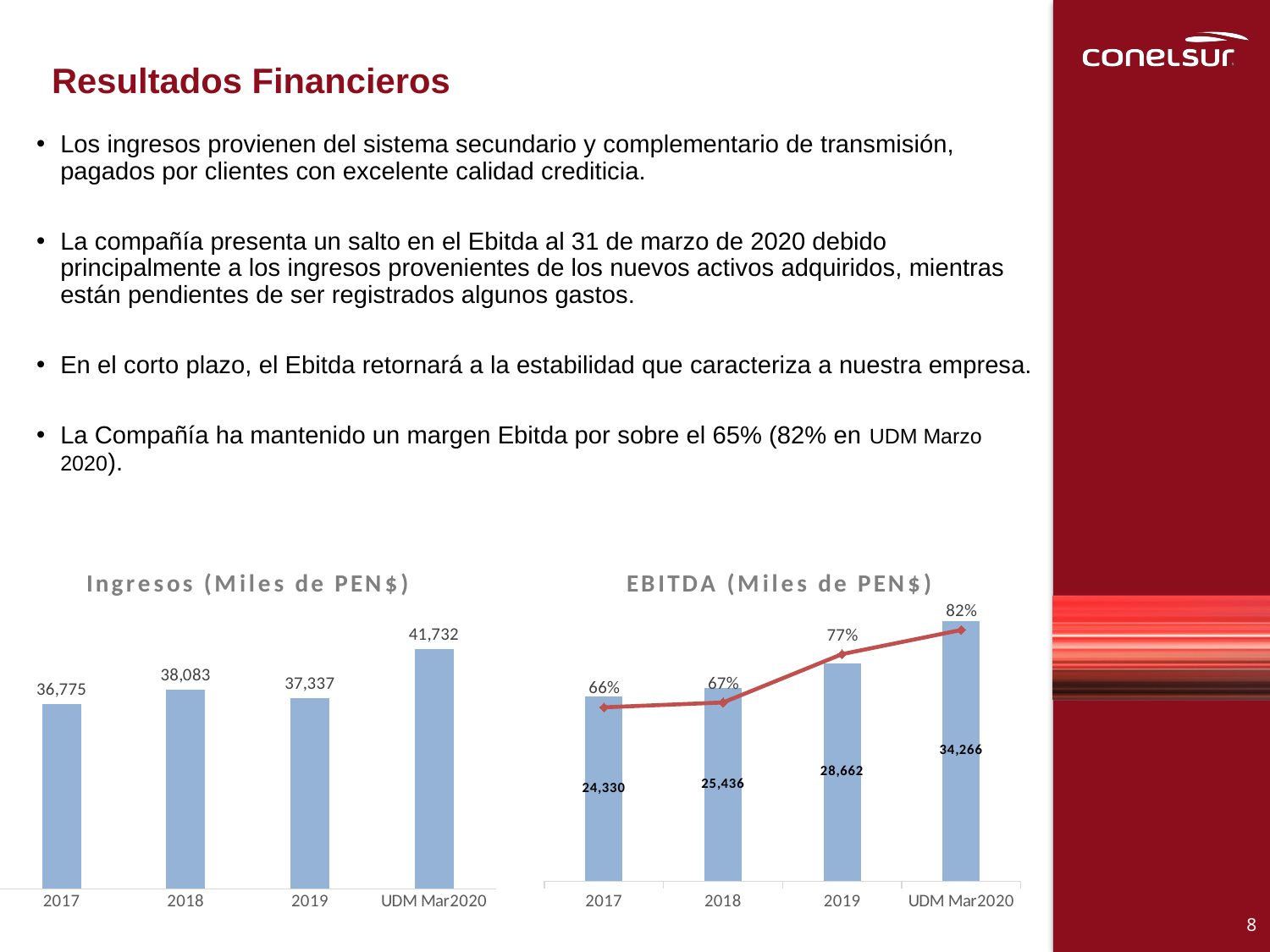
In the 'EBITDA (Miles de PEN$)' chart, what is the difference between the EBITDA values for 2018 and 2017? 1,106 In the 'Ingresos (Miles de PEN$)' chart, which category has the highest value? UDM Mar2020 In the 'EBITDA (Miles de PEN$)' chart, which category has the lowest EBITDA value? 2017 In the 'EBITDA (Miles de PEN$)' chart, what is the EBITDA value for 2019? 28,662 In the 'Ingresos (Miles de PEN$)' chart, which category has the lowest value? 2017 In the 'EBITDA (Miles de PEN$)' chart, what is the margin percentage shown for UDM Mar2020? 82% In the 'Ingresos (Miles de PEN$)' chart, what is the value for 2018? 38,083 What kind of chart is the 'Ingresos (Miles de PEN$)' chart? Bar chart In the 'Ingresos (Miles de PEN$)' chart, what is the difference between the values for UDM Mar2020 and 2019? 4,395 In the 'EBITDA (Miles de PEN$)' chart, do the margin percentages rise or fall from 2017 to UDM Mar2020? Rise In the 'Ingresos (Miles de PEN$)' chart, how many categories are shown on the x axis? 4 In the 'EBITDA (Miles de PEN$)' chart, which is larger, the EBITDA value for 2019 or for 2018? 2019